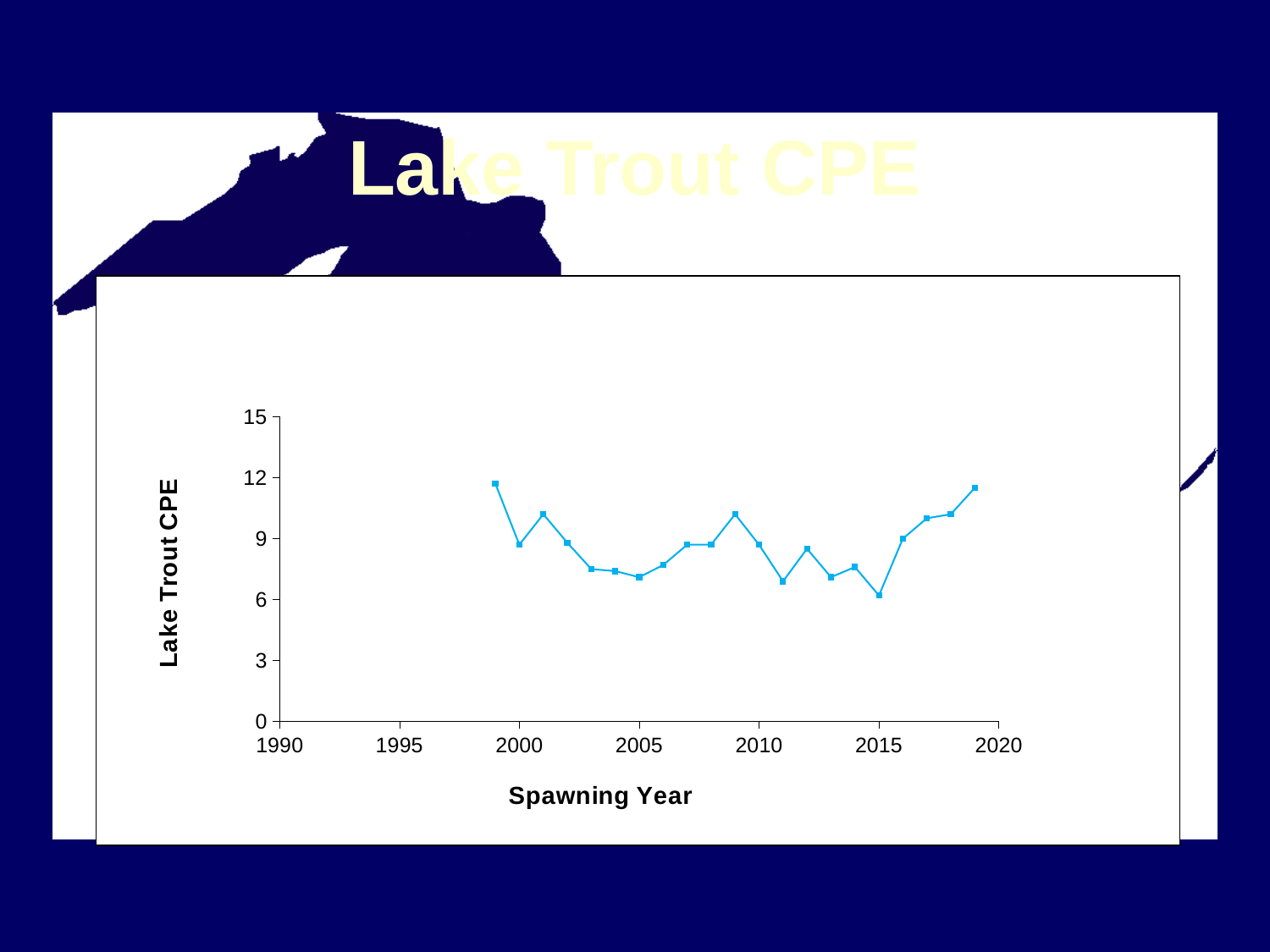
Is the value for 2015 greater or less than 9? less What kind of chart is shown on the slide? line chart What is the label on the x axis of the chart? Spawning Year Which spawning year has the lowest Lake Trout CPE? 2015 Which is larger, the value for 2009 or the value for 2005? 2009 Is the value for 2005 greater or less than 9? less Which is larger, the value for 2015 or the value for 2016? 2016 Do the values rise or fall from 2015 to 2019? rise Is the value for 2009 greater or less than 9? greater How many data points are plotted on the line? 21 What is the title of the chart? Lake Trout CPE